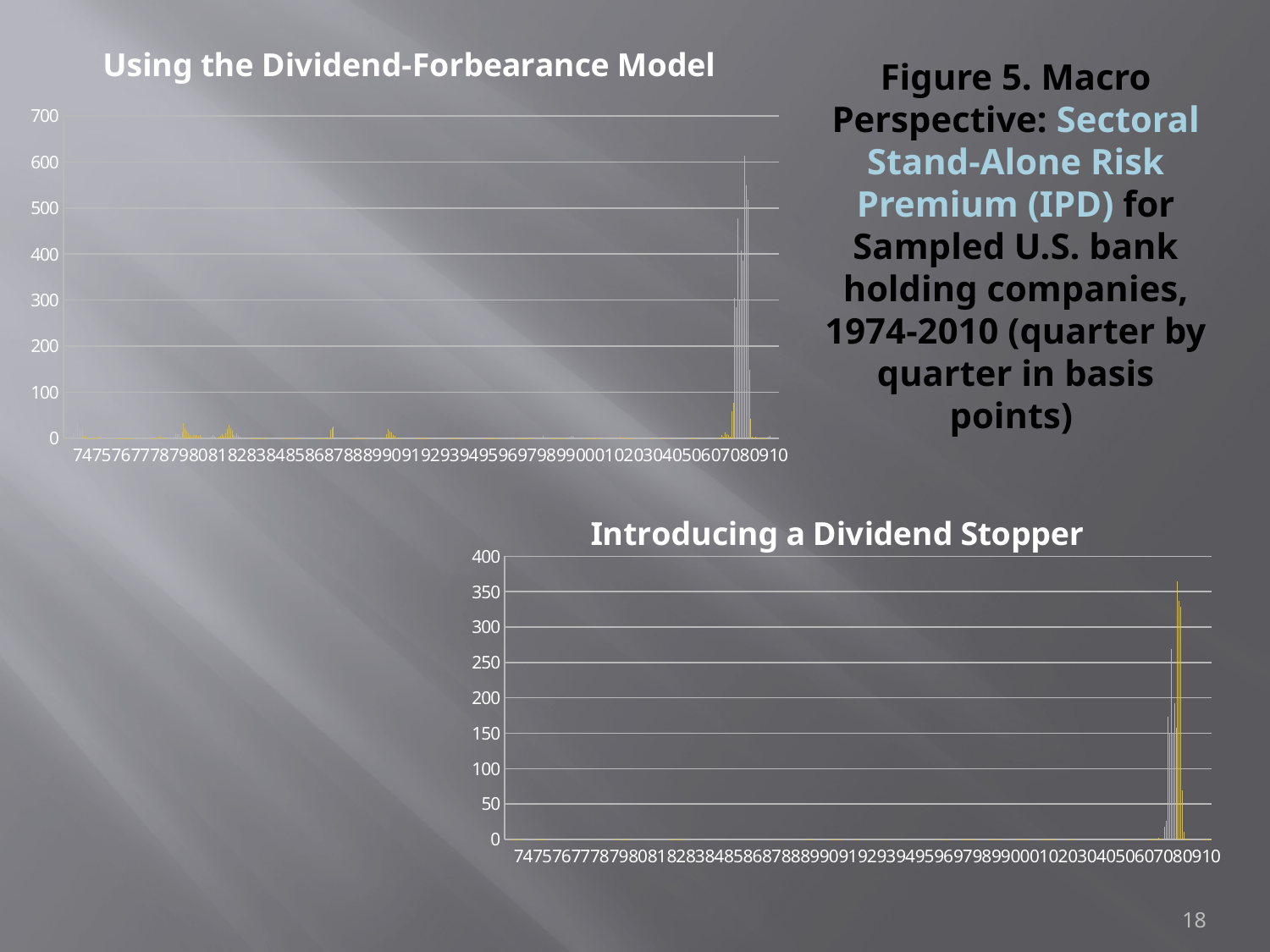
Which chart has the higher peak value, 'Using the Dividend-Forbearance Model' or 'Introducing a Dividend Stopper'? Using the Dividend-Forbearance Model What is the highest value shown on the y axis of the 'Using the Dividend-Forbearance Model' chart? 700 What kind of chart is 'Using the Dividend-Forbearance Model'? bar chart In the 'Introducing a Dividend Stopper' chart, are the values near the start of the x axis (74) higher or lower than those near 08-09? lower What is the first x-axis label on the 'Introducing a Dividend Stopper' chart? 74 What kind of chart is 'Introducing a Dividend Stopper'? bar chart In the 'Using the Dividend-Forbearance Model' chart, is the tallest bar greater or less than 500? greater In the 'Introducing a Dividend Stopper' chart, is the tallest bar greater or less than 300? greater What is the highest value shown on the y axis of the 'Introducing a Dividend Stopper' chart? 400 In the 'Using the Dividend-Forbearance Model' chart, is the value for 80 greater or less than 100? less In the 'Using the Dividend-Forbearance Model' chart, do the values stay low or spike sharply toward the right end of the x axis? spike sharply toward the right end